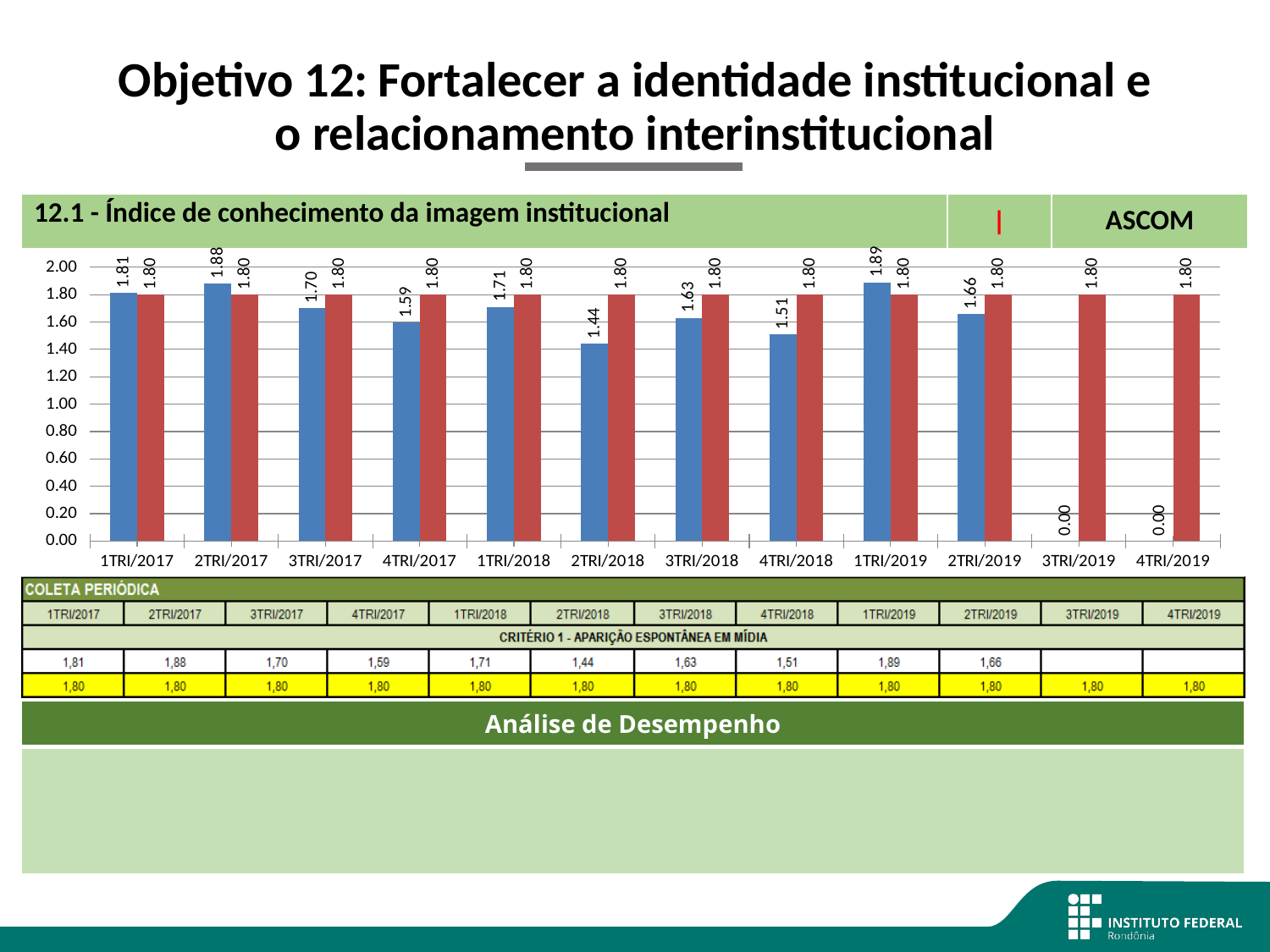
What is the difference between the blue bar for 1TRI/2019 and the blue bar for 2TRI/2018? 0.45 For 3TRI/2018, which is larger, the blue bar or the red bar? The red bar Among the quarters with a non-zero blue bar, which has the lowest blue value? 2TRI/2018 How many quarters are shown on the x axis of the chart? 12 What is the value of the blue bar for 4TRI/2018? 1.51 What is the value of the blue bar for 2TRI/2017? 1.88 Is the blue bar for 2TRI/2018 greater or less than 1.60? less Which quarter has the highest blue bar? 1TRI/2019 What kind of chart is shown on the slide? Bar chart What is the value of the red bar for 3TRI/2019? 1.80 What is the difference between the blue bar and the red bar for 2TRI/2017? 0.08 Do the blue bars rise or fall from 2TRI/2017 to 4TRI/2017? Fall